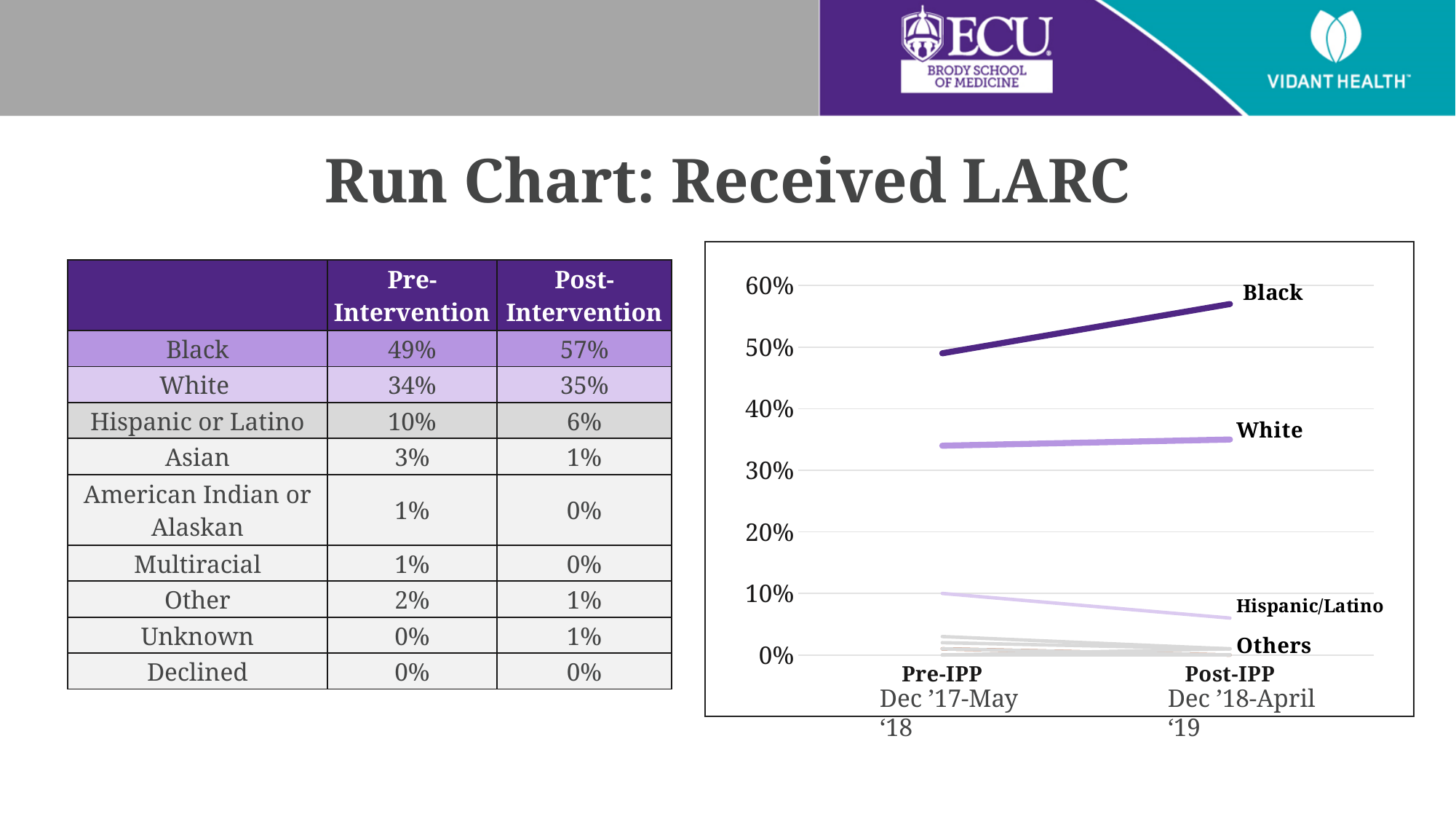
According to the table, what is the difference between the Pre-Intervention and Post-Intervention values for Black? 8% In the line chart, does the Black line rise or fall from Pre-IPP to Post-IPP? rise According to the table, what is the Pre-Intervention value for Hispanic or Latino? 10% In the line chart, which is larger at Pre-IPP: the White line or the Hispanic/Latino line? White What is the title of the slide? Run Chart: Received LARC In the line chart, is the Black value at Post-IPP greater or less than 50%? greater What kind of chart is shown on the right of the slide? line chart According to the table, what is the Post-Intervention value for Black? 57% In the line chart, does the Hispanic/Latino line rise or fall from Pre-IPP to Post-IPP? fall In the line chart, which labelled group has the highest value at Post-IPP? Black In the line chart, is the White value at Pre-IPP greater or less than 40%? less How many time points are shown on the x axis of the line chart? 2